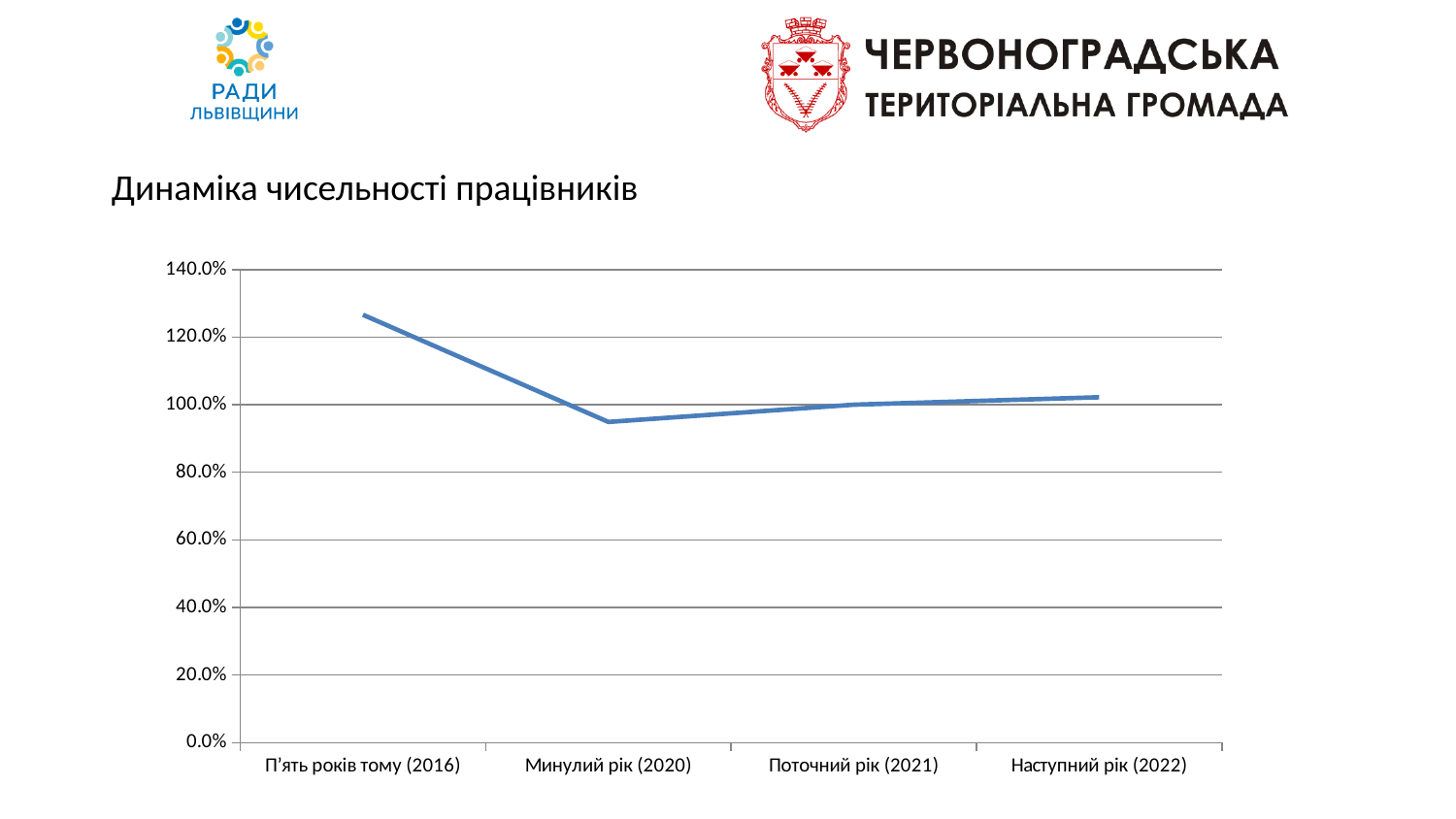
What is the title of the chart? Динаміка чисельності працівників Is the value for Наступний рік (2022) greater or less than 120.0%? less Is the value for П'ять років тому (2016) greater or less than 120.0%? greater Which category has the lowest value? Минулий рік (2020) How many data points are plotted on the line? 4 What colour is the line in the chart? blue What kind of chart is shown on the slide? line chart Which is larger, the value for П'ять років тому (2016) or for Минулий рік (2020)? П'ять років тому (2016) Which category has the highest value? П'ять років тому (2016) Is the value for Минулий рік (2020) greater or less than 100.0%? less Does the line rise or fall from П'ять років тому (2016) to Минулий рік (2020)? fall